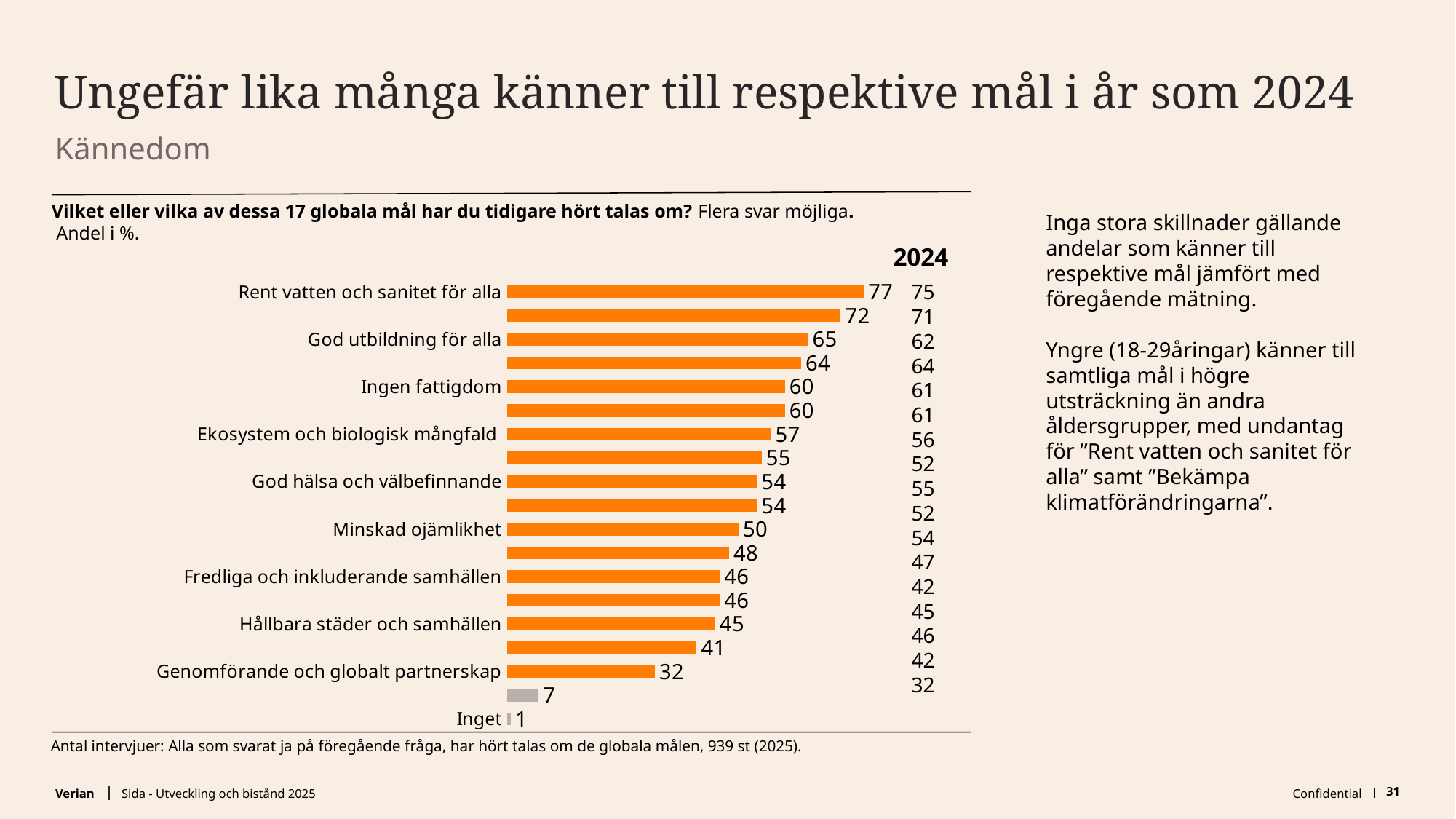
What is the value for "Inget"? 1 What colour are the bars for the global goals in the chart? orange Which category has the lowest value? Inget What is the value for "Rent vatten och sanitet för alla"? 77 What is the 2024 value shown for "Rent vatten och sanitet för alla"? 75 What is the difference between the values for "Rent vatten och sanitet för alla" and "God utbildning för alla"? 12 Which category has the highest value? Rent vatten och sanitet för alla What is the value for "God utbildning för alla"? 65 What is the value for "Genomförande och globalt partnerskap"? 32 What is the value for "Ingen fattigdom"? 60 Which is larger, the value for "God utbildning för alla" or for "Ingen fattigdom"? God utbildning för alla What type of chart is shown on the slide? bar chart